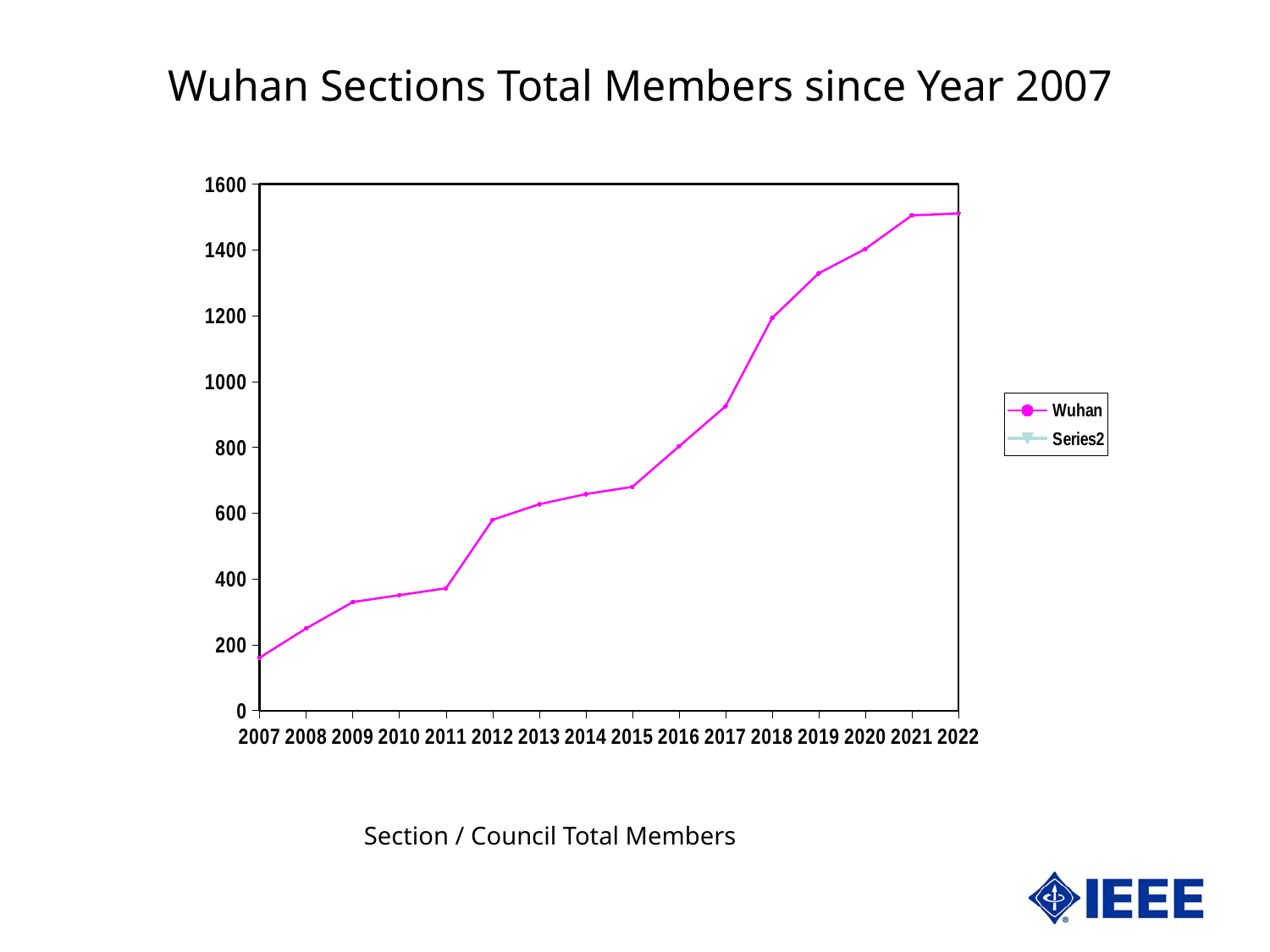
How many years are shown on the x axis? 16 Which year has the larger Wuhan value, 2017 or 2018? 2018 Is the Wuhan value for 2011 greater or less than 400? less What is the title of the chart? Wuhan Sections Total Members since Year 2007 Which year has the lowest value for Wuhan? 2007 Is the Wuhan value for 2019 greater or less than 1200? greater How many series does the legend list? 2 Is the Wuhan value for 2021 greater or less than 1400? greater What kind of chart is shown on the slide? line chart Do the Wuhan values rise or fall from 2007 to 2022? rise